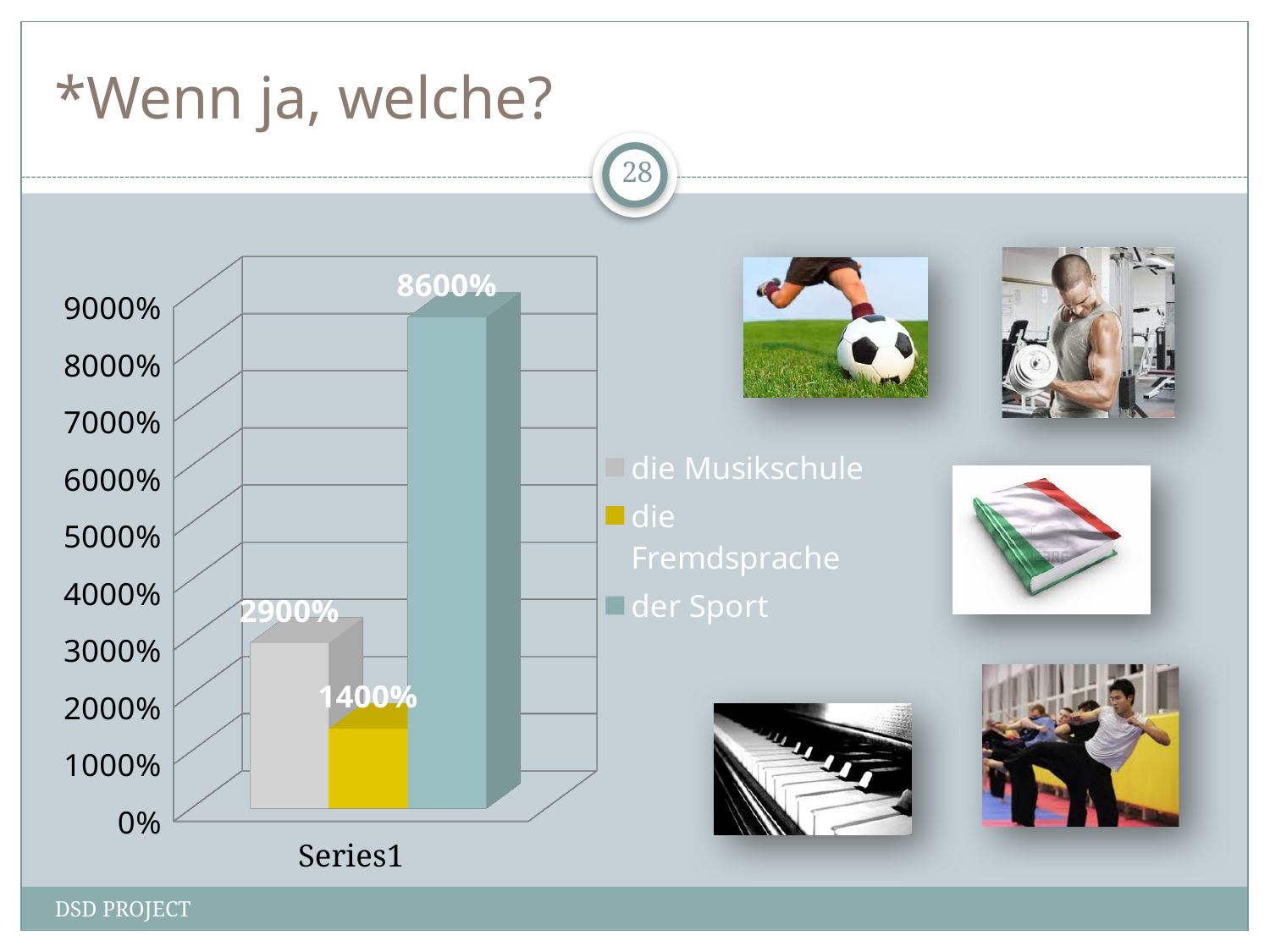
Which legend entry has the lowest value? die Fremdsprache What value is shown for der Sport? 8600% Is the value for der Sport greater or less than 8000%? greater What is the difference between the values for die Musikschule and die Fremdsprache? 1500% How many series does the legend list? 3 Which legend entry has the highest value? der Sport What value is shown for die Musikschule? 2900% What colour is the bar for die Fremdsprache? yellow What is the difference between the values for der Sport and die Musikschule? 5700% What kind of chart is shown on the slide? bar chart Which is larger, the value for die Musikschule or the value for die Fremdsprache? die Musikschule What value is shown for die Fremdsprache? 1400%